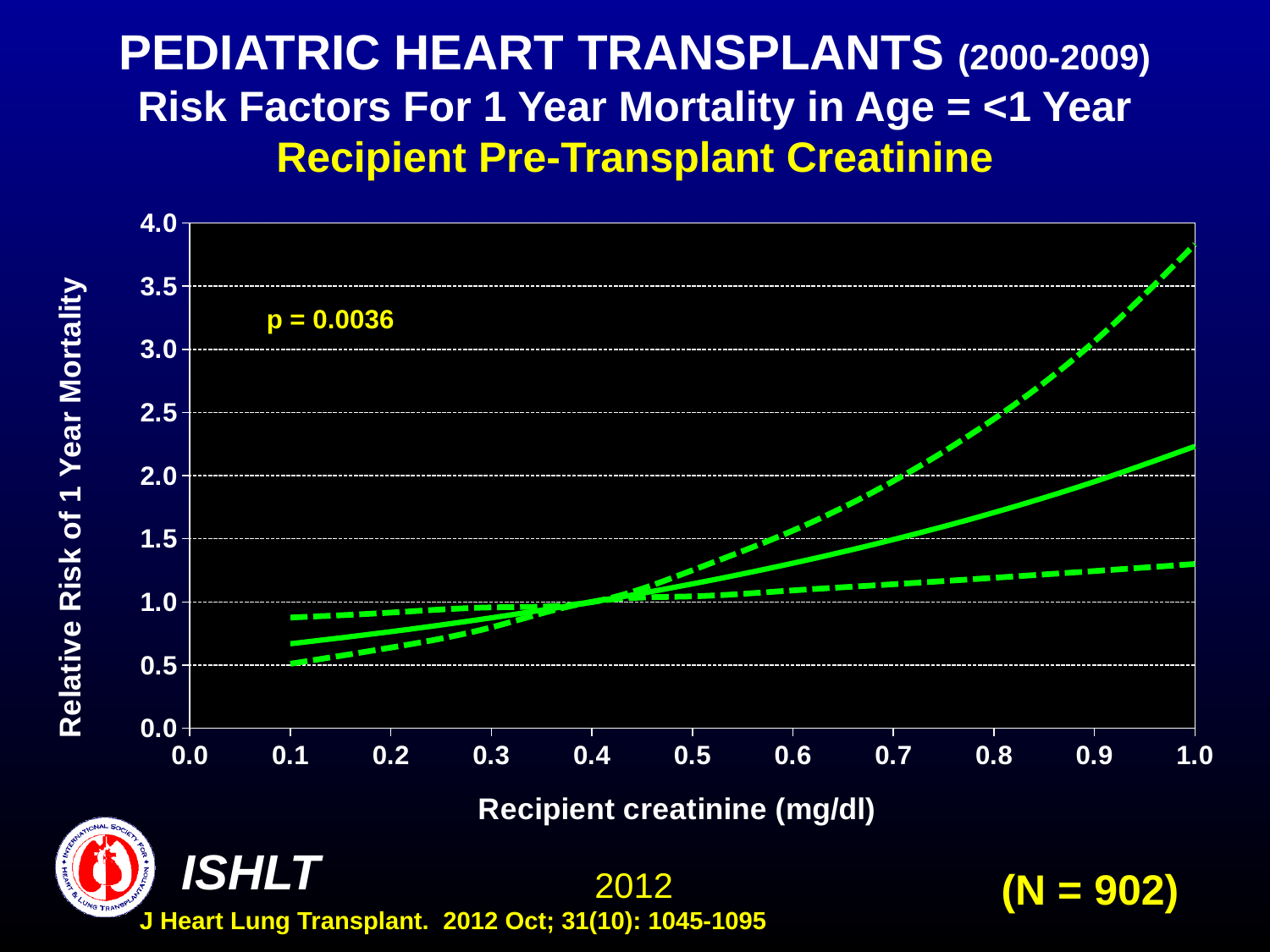
Is the value of the upper dashed line at a recipient creatinine of 1.0 mg/dl greater or less than 3.5? greater Is the value of the solid line at a recipient creatinine of 0.1 mg/dl greater or less than 1.0? less What p-value is printed on the chart? p = 0.0036 What kind of chart is shown on the slide? line chart At a recipient creatinine of 1.0 mg/dl, which is larger: the upper dashed line or the solid line? the upper dashed line Does the solid line for relative risk of 1 year mortality rise or fall as recipient creatinine increases from 0.1 to 1.0 mg/dl? rise Is the value of the solid line at a recipient creatinine of 1.0 mg/dl greater or less than 2.0? greater What is the label of the x axis? Recipient creatinine (mg/dl) How many lines are plotted on the chart? 3